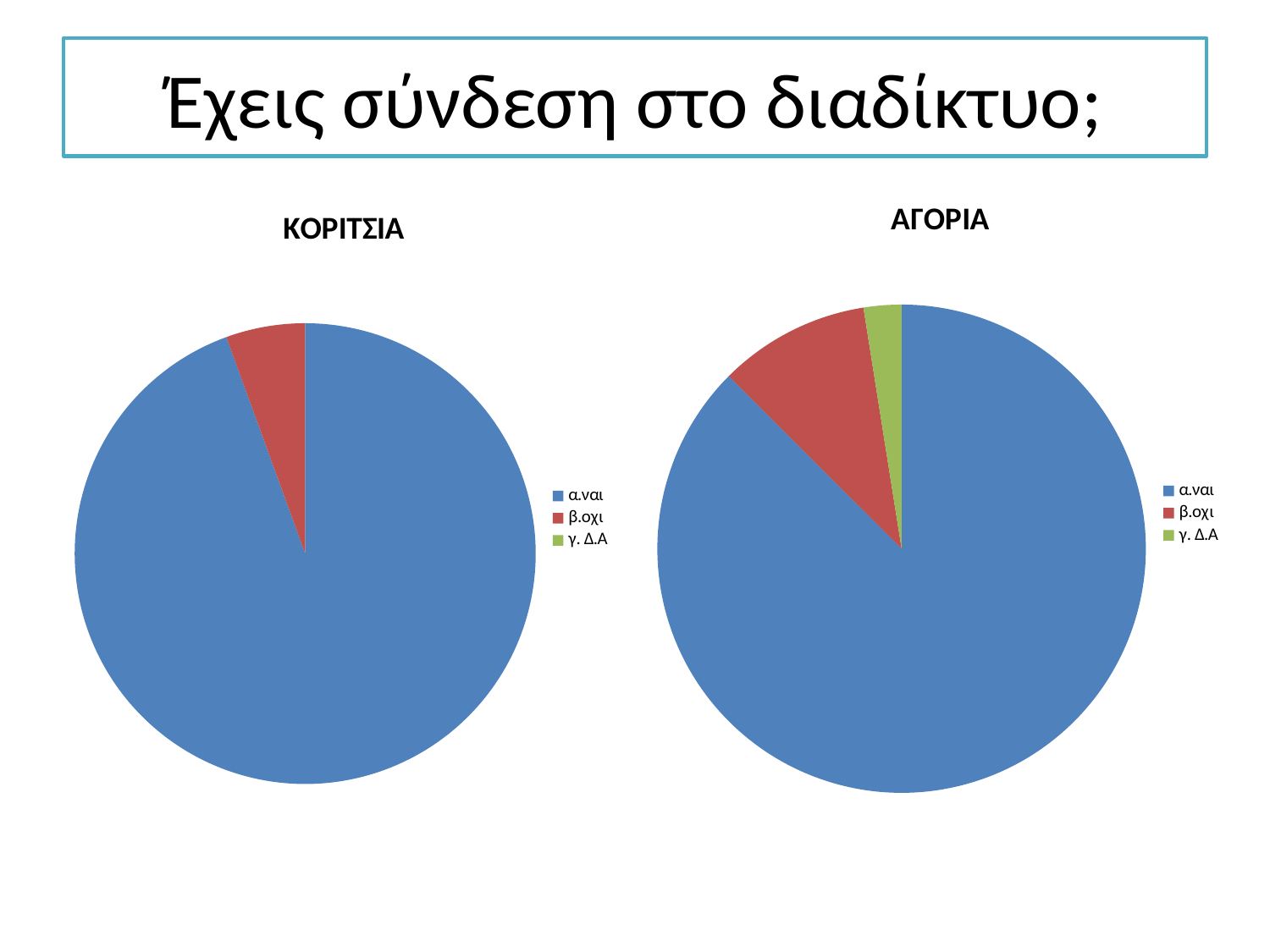
How many categories does the legend of the ΑΓΟΡΙΑ chart list? 3 In the ΑΓΟΡΙΑ chart, which category has the largest slice? α.ναι How many slices are visible in the ΑΓΟΡΙΑ pie chart? 3 How many slices are visible in the ΚΟΡΙΤΣΙΑ pie chart? 2 In the ΚΟΡΙΤΣΙΑ chart, which category has the largest slice? α.ναι In the ΚΟΡΙΤΣΙΑ chart, which slice is larger: α.ναι or β.οχι? α.ναι In the ΑΓΟΡΙΑ chart, which slice is larger: β.οχι or γ. Δ.Α? β.οχι What kind of chart is the ΚΟΡΙΤΣΙΑ chart? pie chart What kind of chart is the ΑΓΟΡΙΑ chart? pie chart What is the title of the chart on the left side of the slide? ΚΟΡΙΤΣΙΑ What colour represents β.οχι in the ΑΓΟΡΙΑ chart? red In the ΑΓΟΡΙΑ chart, which category has the smallest slice? γ. Δ.Α